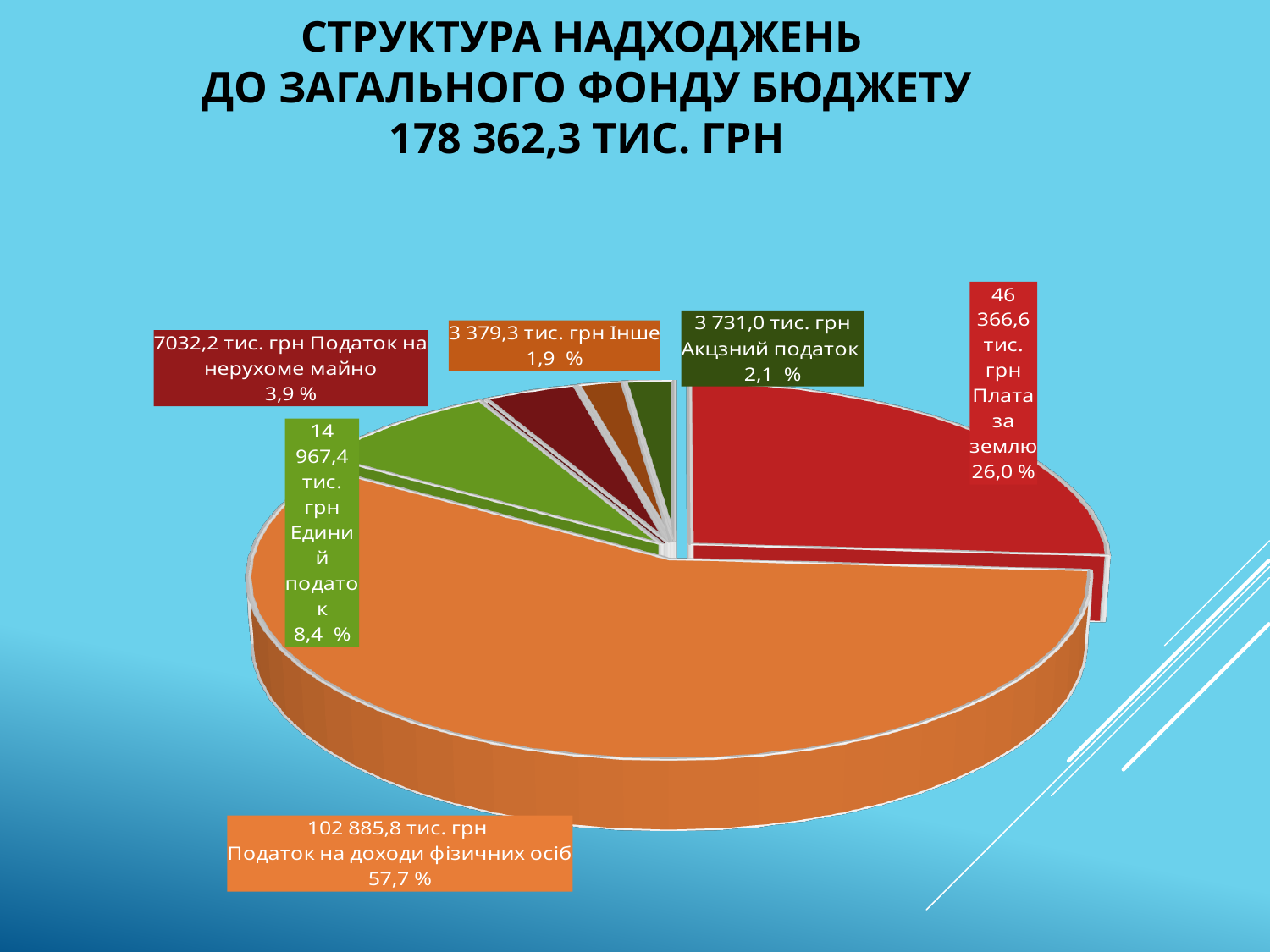
What share of the pie does Податок на нерухоме майно represent? 3,9 % Which is larger: Плата за землю or Единий податок? Плата за землю What total amount is stated in the chart title? 178 362,3 тис. грн What kind of chart is shown on the slide? pie chart Which category has the largest slice of the pie? Податок на доходи фізичних осіб What is the value for Податок на доходи фізичних осіб? 102 885,8 тис. грн What is the difference between the values for Акцзний податок and Інше? 351,7 тис. грн What is the value for Плата за землю? 46 366,6 тис. грн How many slices does the pie chart have? 6 Which category has the smallest slice of the pie? Інше What is the value for Единий податок? 14 967,4 тис. грн What share of the pie does Акцзний податок represent? 2,1 %